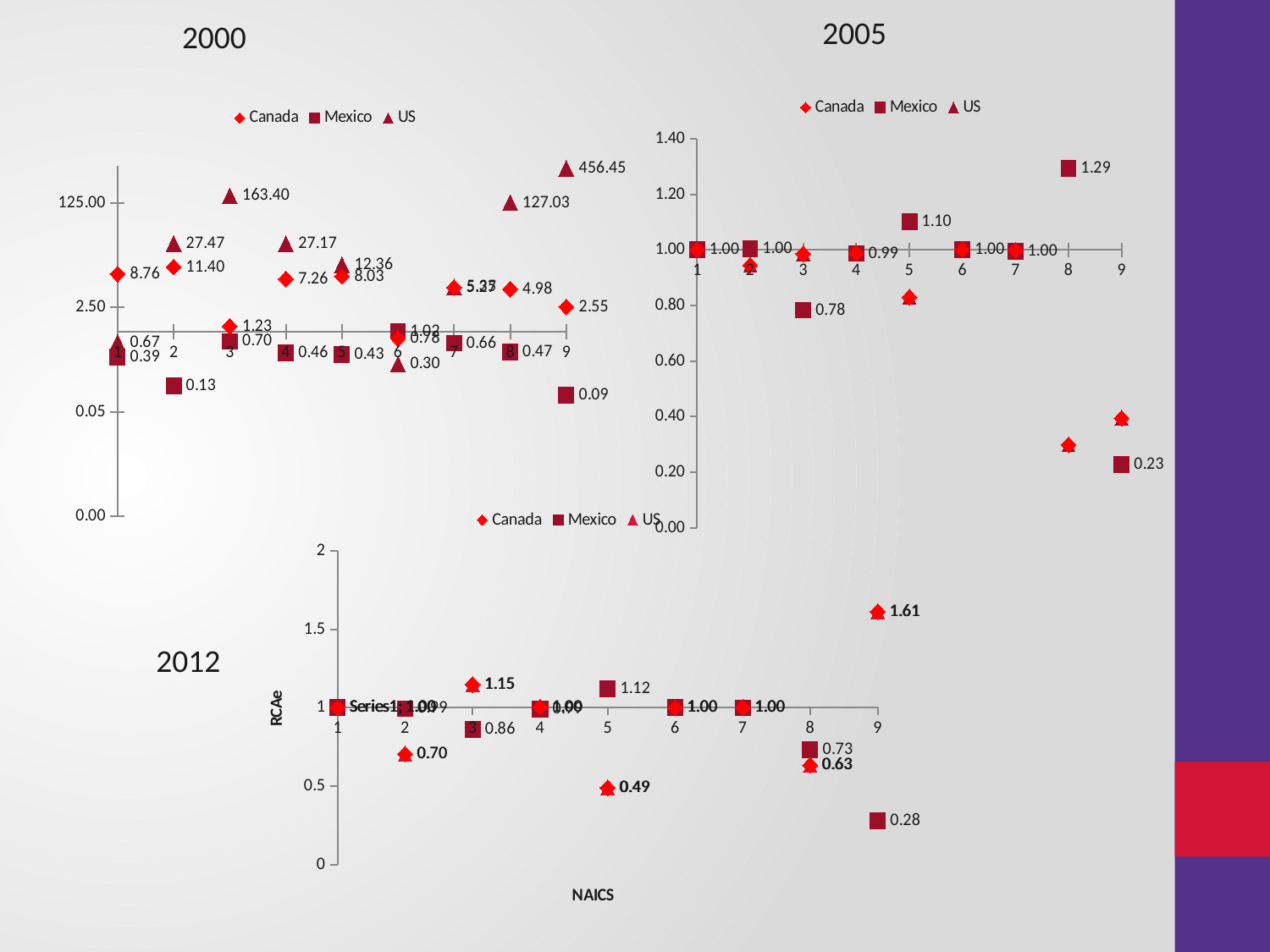
In the 2012 chart, what is the difference between the Mexico value (1.12) and the Canada value (0.49) at NAICS 5? 0.63 How many series does the legend of the 2005 chart list? 3 In the 2005 chart, what is the Mexico value at NAICS 8? 1.29 What is the title of the vertical axis on the 2012 chart? RCAe In the 2012 chart, which is larger at NAICS 3, the Canada value or the Mexico value? Canada In the 2000 chart, which NAICS category has the lowest Mexico value? 9 In the 2000 chart, what is the US value at NAICS 9? 456.45 In the 2000 chart, what is the Mexico value at NAICS 2? 0.13 In the 2012 chart, what is the Canada value at NAICS 9? 1.61 In the 2005 chart, what is the Mexico value at NAICS 9? 0.23 In the 2005 chart, is the Canada value at NAICS 8 greater or less than 0.40? less In the 2000 chart, which NAICS category has the highest US value? 9